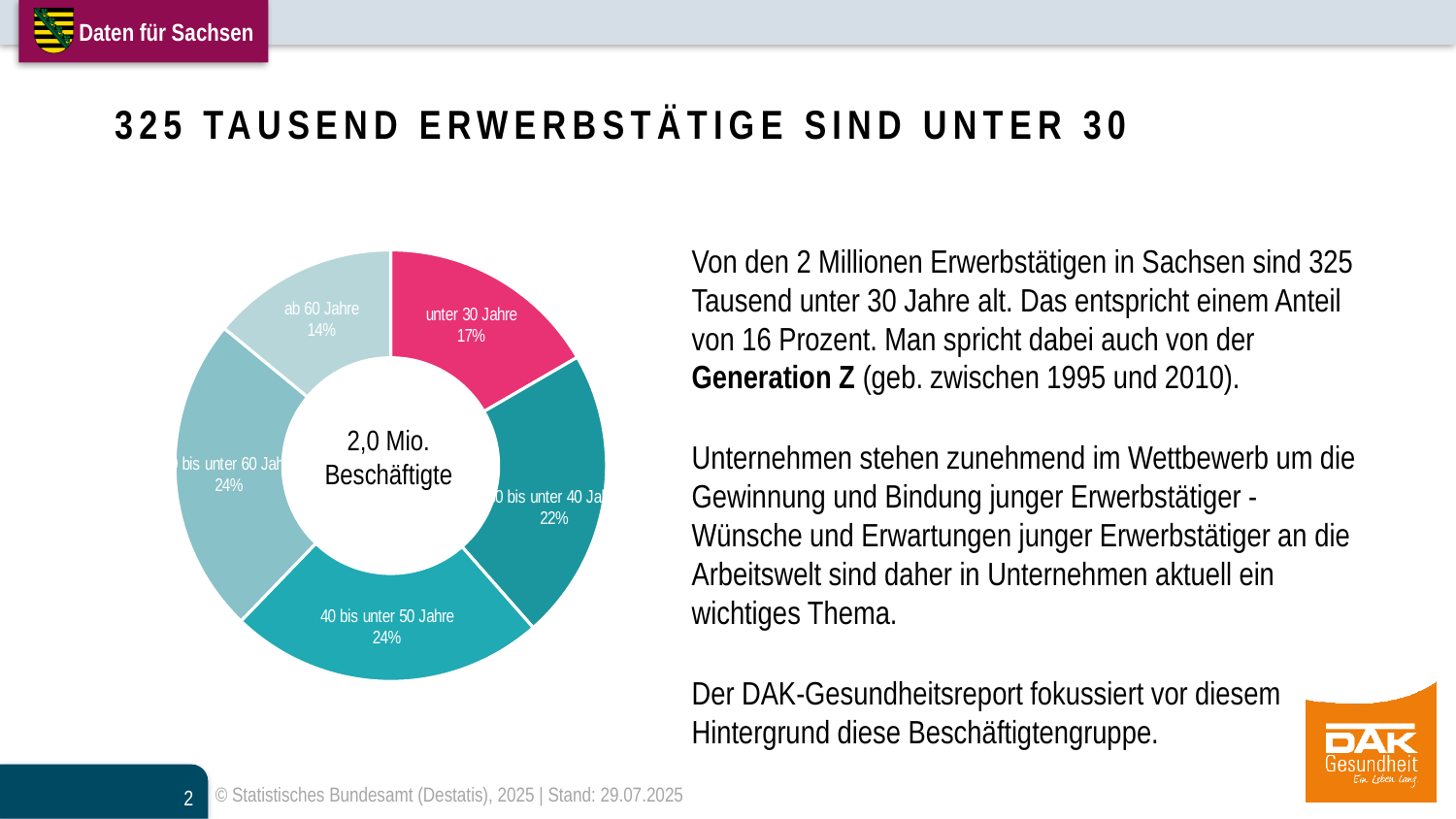
Which segment of the donut chart is coloured pink/magenta? unter 30 Jahre Which is larger in the donut chart: the share for "unter 30 Jahre" or the share for "ab 60 Jahre"? unter 30 Jahre How many age-group segments does the donut chart have? 5 By how many percentage points does the "unter 30 Jahre" share exceed the "ab 60 Jahre" share? 3 percentage points What kind of chart is shown on the slide? Donut (pie) chart What text is shown in the centre of the donut chart? 2,0 Mio. Beschäftigte By how many percentage points does the "40 bis unter 50 Jahre" share exceed the "unter 30 Jahre" share? 7 percentage points What share of the donut chart is labelled "40 bis unter 50 Jahre"? 24% What share of the donut chart is labelled "ab 60 Jahre"? 14% What share of the donut chart is labelled "unter 30 Jahre"? 17% Which age group has the smallest share in the donut chart? ab 60 Jahre